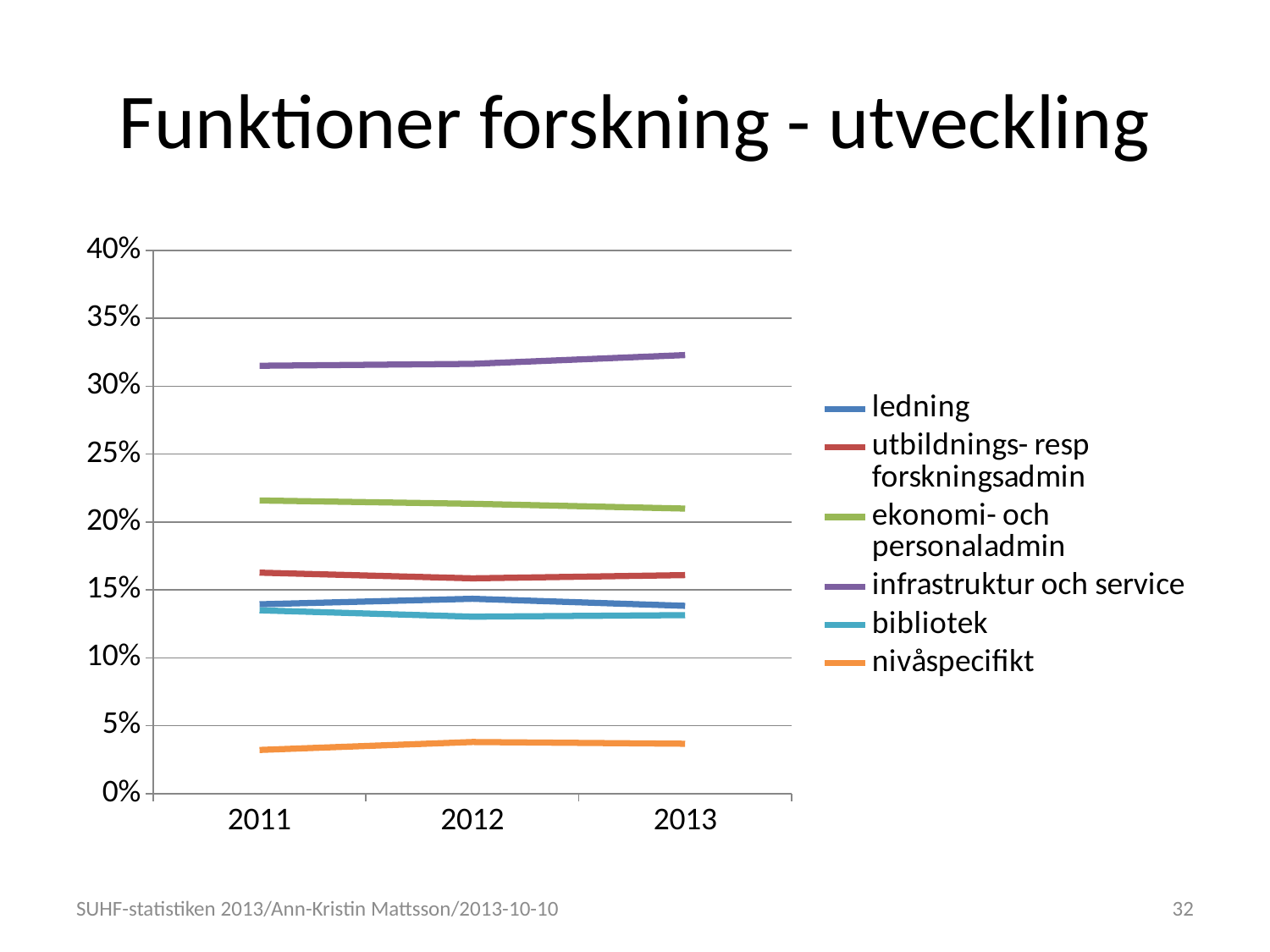
What kind of chart is shown on the slide? line chart In 2013, which is larger: ekonomi- och personaladmin or utbildnings- resp forskningsadmin? ekonomi- och personaladmin Which series has the highest values across all years? infrastruktur och service Does the line for ekonomi- och personaladmin rise or fall from 2011 to 2013? fall Is the value for infrastruktur och service in 2013 greater or less than 30%? greater Is the value for bibliotek in 2013 greater or less than 15%? less Does the line for infrastruktur och service rise or fall from 2011 to 2013? rise Is the value for ekonomi- och personaladmin in 2011 greater or less than 20%? greater How many series does the legend list? 6 Which series has the lowest values across all years? nivåspecifikt How many years are shown on the x axis? 3